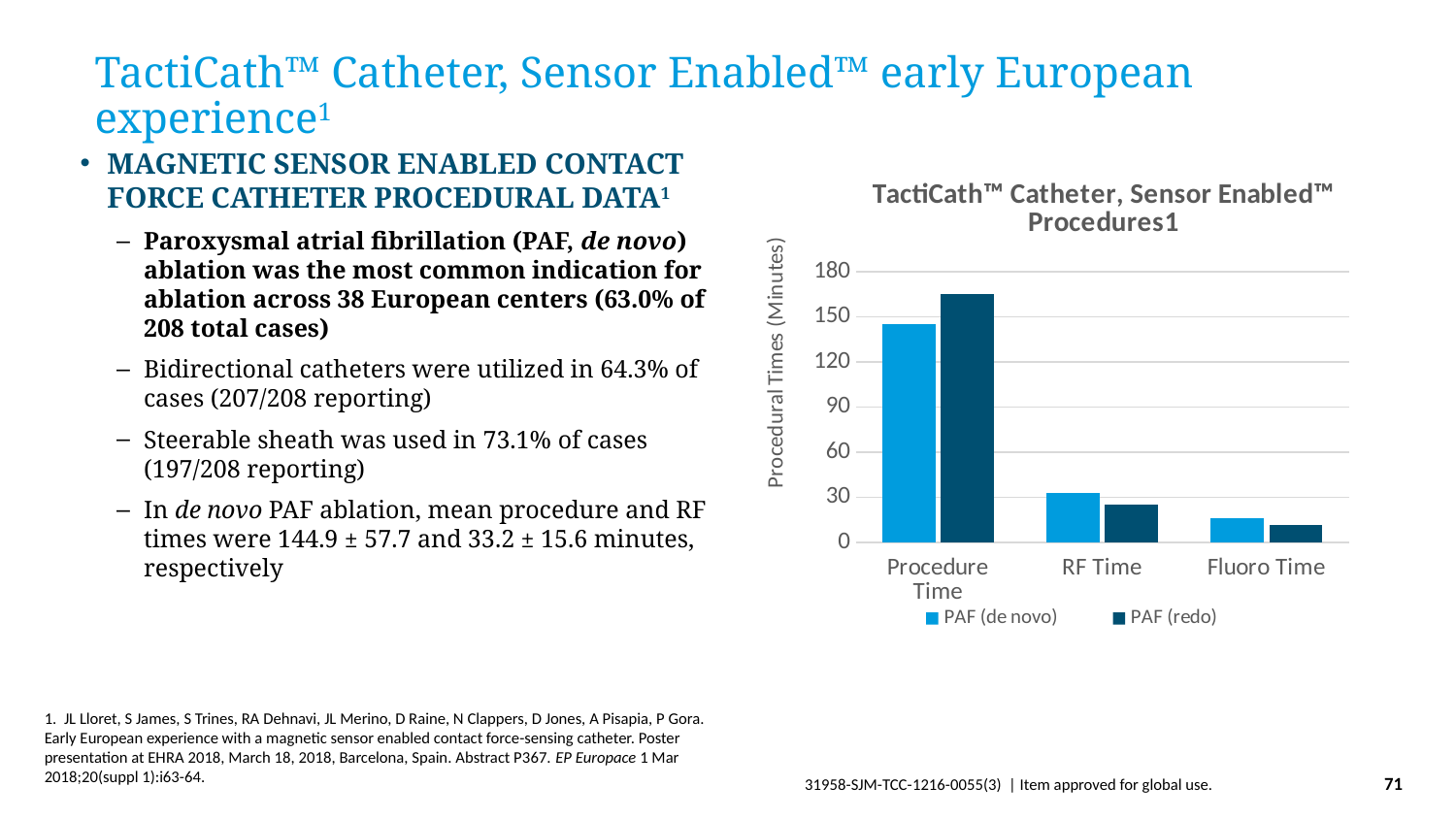
What is the label on the y axis of the chart? Procedural Times (Minutes) For RF Time, which series has the larger value, PAF (de novo) or PAF (redo)? PAF (de novo) Which category has the lowest value for PAF (redo)? Fluoro Time What kind of chart is shown on the slide? bar chart Is the RF Time value for PAF (redo) greater or less than 30? less Is the Procedure Time value for PAF (redo) greater or less than 150? greater Which category has the highest value for PAF (de novo)? Procedure Time How many categories are shown on the x axis of the chart? 3 For Procedure Time, which series has the larger value, PAF (de novo) or PAF (redo)? PAF (redo) Do the PAF (de novo) values rise or fall from left to right across the x axis? fall Is the Procedure Time value for PAF (de novo) greater or less than 120? greater How many series does the chart legend list? 2